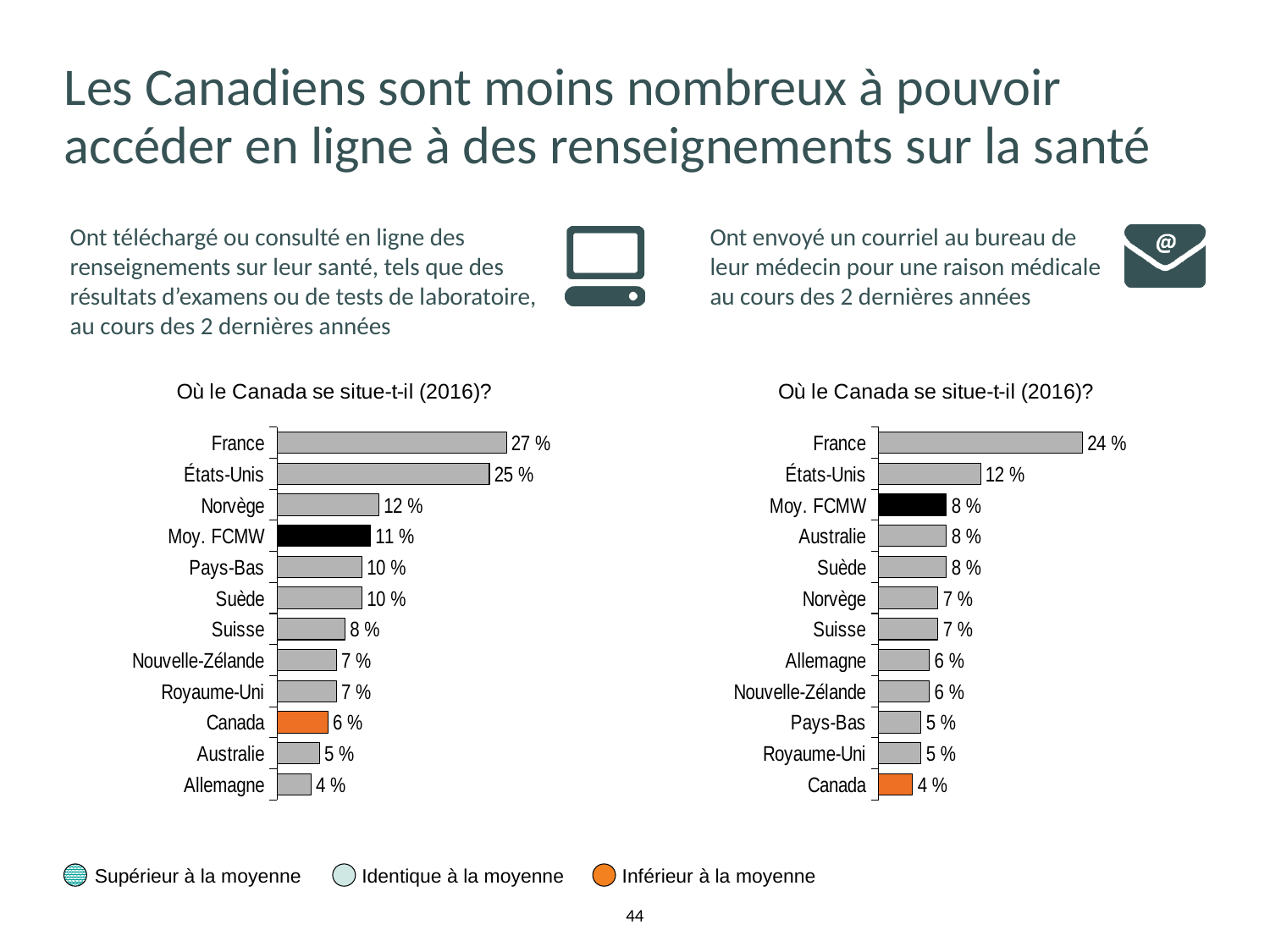
How many categories are shown in the left chart? 12 In the left chart, what is the value for Moy. FCMW? 11 % In the right chart, which country has the lowest value? Canada In the right chart, which is larger, the value for États-Unis or the value for Australie? États-Unis In the right chart, what is the value for Pays-Bas? 5 % In the right chart, what is the difference between France and États-Unis? 12 % In the left chart, which is larger, the value for Norvège or the value for Moy. FCMW? Norvège In the left chart, what is the difference between France and États-Unis? 2 % In the left chart, what is the value for Canada? 6 % What type of chart is the right chart? Bar chart In the right chart, what is the value for France? 24 % In the left chart, which country has the highest value? France